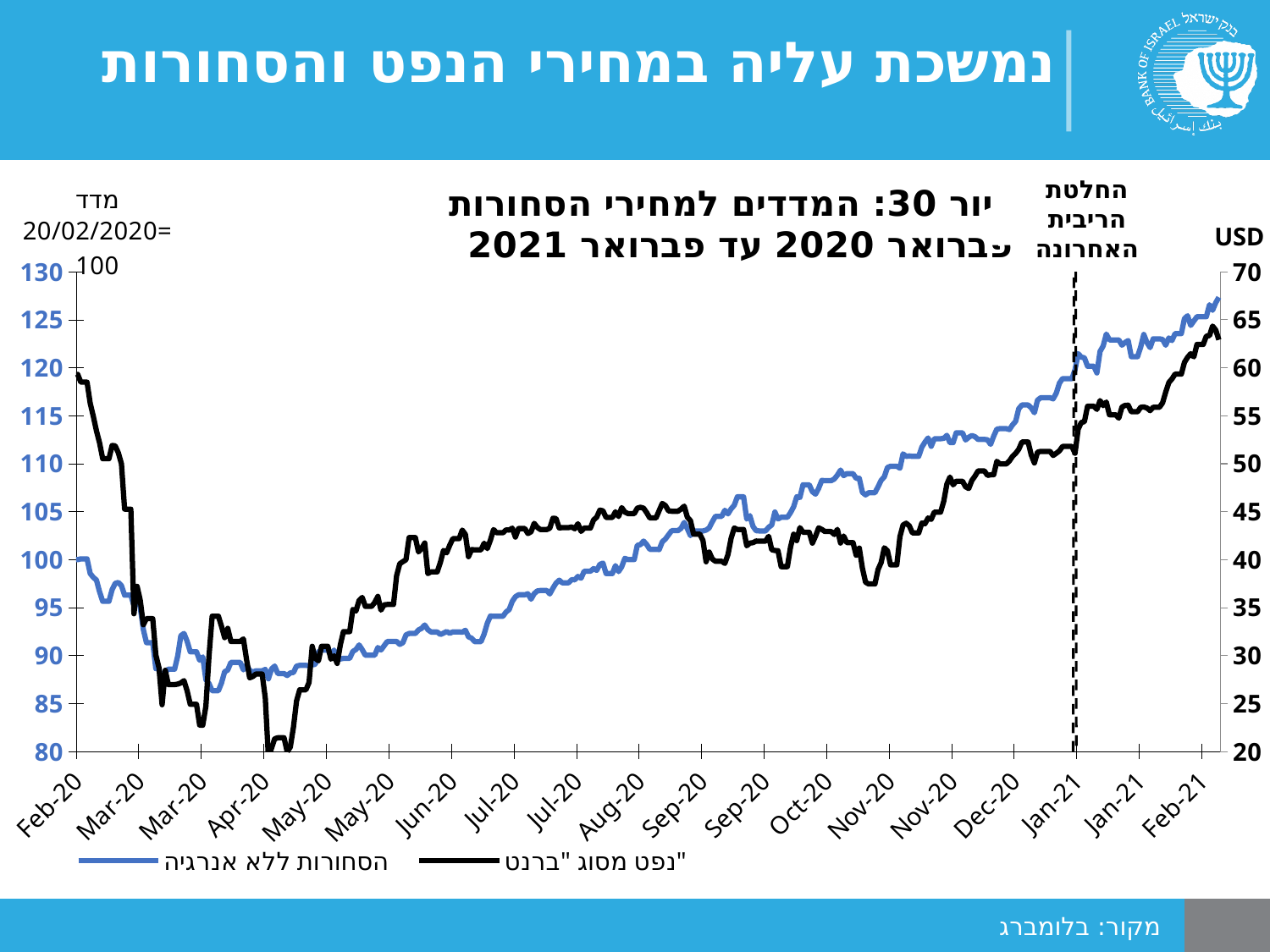
Which two series are shown in the legend? הסחורות ללא אנרגיה and נפט מסוג "ברנט" What does the dashed vertical line near Jan-21 mark, according to the label above it? החלטת הריבית האחרונה How many series does the legend list? 2 Is the lowest point of the blue line (הסחורות ללא אנרגיה), reached around March 2020, greater or less than 90 on the left axis? less Does the black line (נפט מסוג ברנט) rise or fall between Feb-20 and Apr-20? fall Is the value of the black line (נפט מסוג ברנט) at the start of the series in Feb-20 greater or less than 55 USD? greater Does the blue line (הסחורות ללא אנרגיה) rise or fall between May-20 and Feb-21? rise Is the value of the blue line (הסחורות ללא אנרגיה) at the end of the series in Feb-21 greater or less than 120 on the left axis? greater What is the source cited at the bottom of the slide? בלומברג What kind of chart is shown on the slide? Line chart